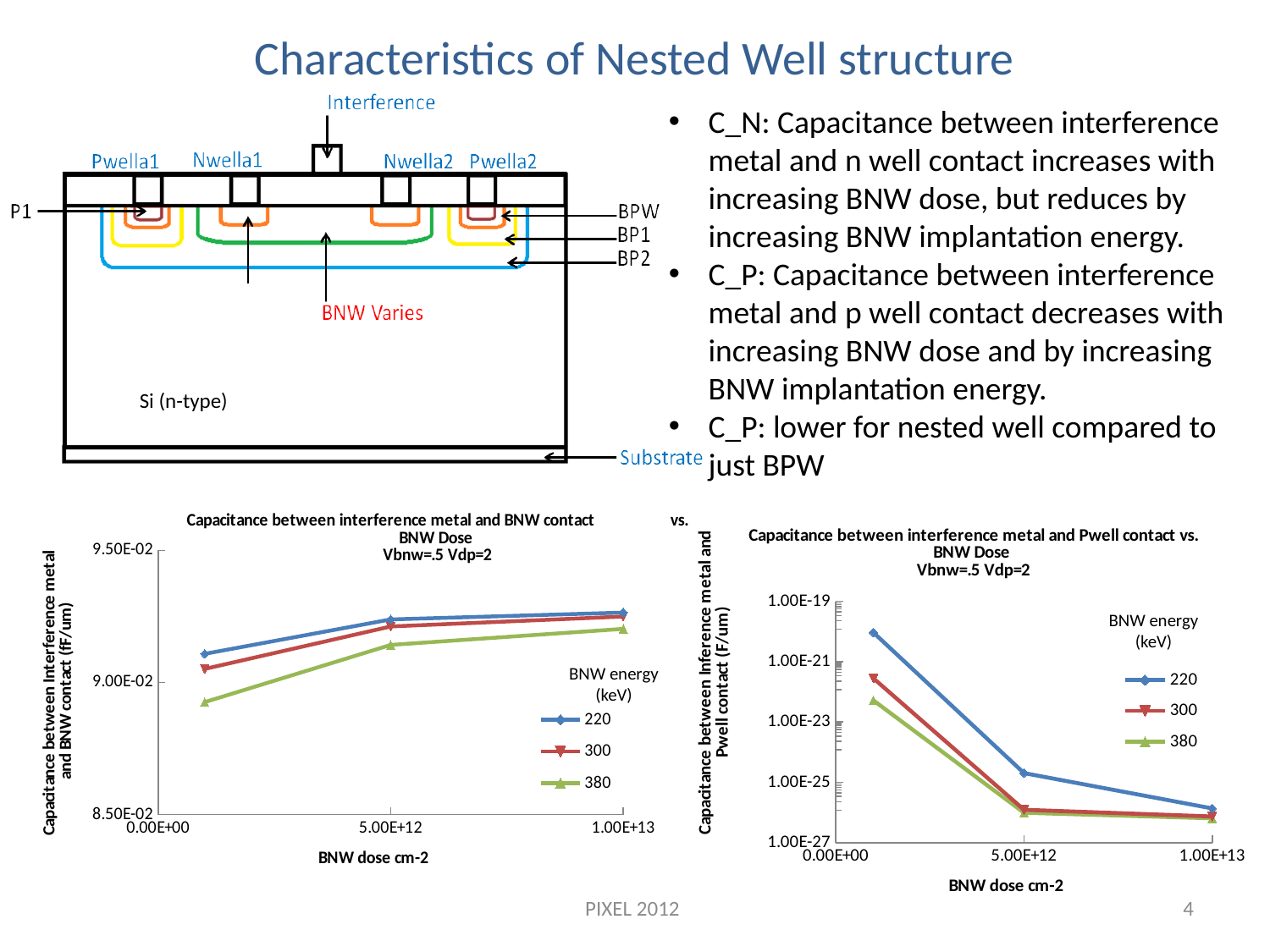
In the left chart (BNW contact), at the lowest BNW dose, which series has the larger value: 220 keV or 380 keV? 220 How many data points does each series have in the right chart (Pwell contact)? 3 In the right chart (Pwell contact), is the value for the 220 keV series at the lowest BNW dose greater or less than 1.00E-21? greater In the left chart (BNW contact), is the value for the 380 keV series at the lowest BNW dose greater or less than 9.00E-02? less In the right chart (Pwell contact), do the values for the 220 keV series rise or fall as BNW dose increases? fall In the right chart (Pwell contact), is the value for the 380 keV series at a BNW dose of 5.00E+12 greater or less than 1.00E-25? less In the left chart (BNW contact), do the values for the 220 keV series rise or fall as BNW dose increases? rise How many series does the legend of the right chart, 'Capacitance between interference metal and Pwell contact vs. BNW Dose', list? 3 In the right chart (Pwell contact), at the lowest BNW dose, which series has the larger value: 220 keV or 380 keV? 220 In the left chart (BNW contact), what are the BNW energy values listed in the legend? 220, 300, 380 What kind of chart is the left chart, 'Capacitance between interference metal and BNW contact vs. BNW Dose'? line chart